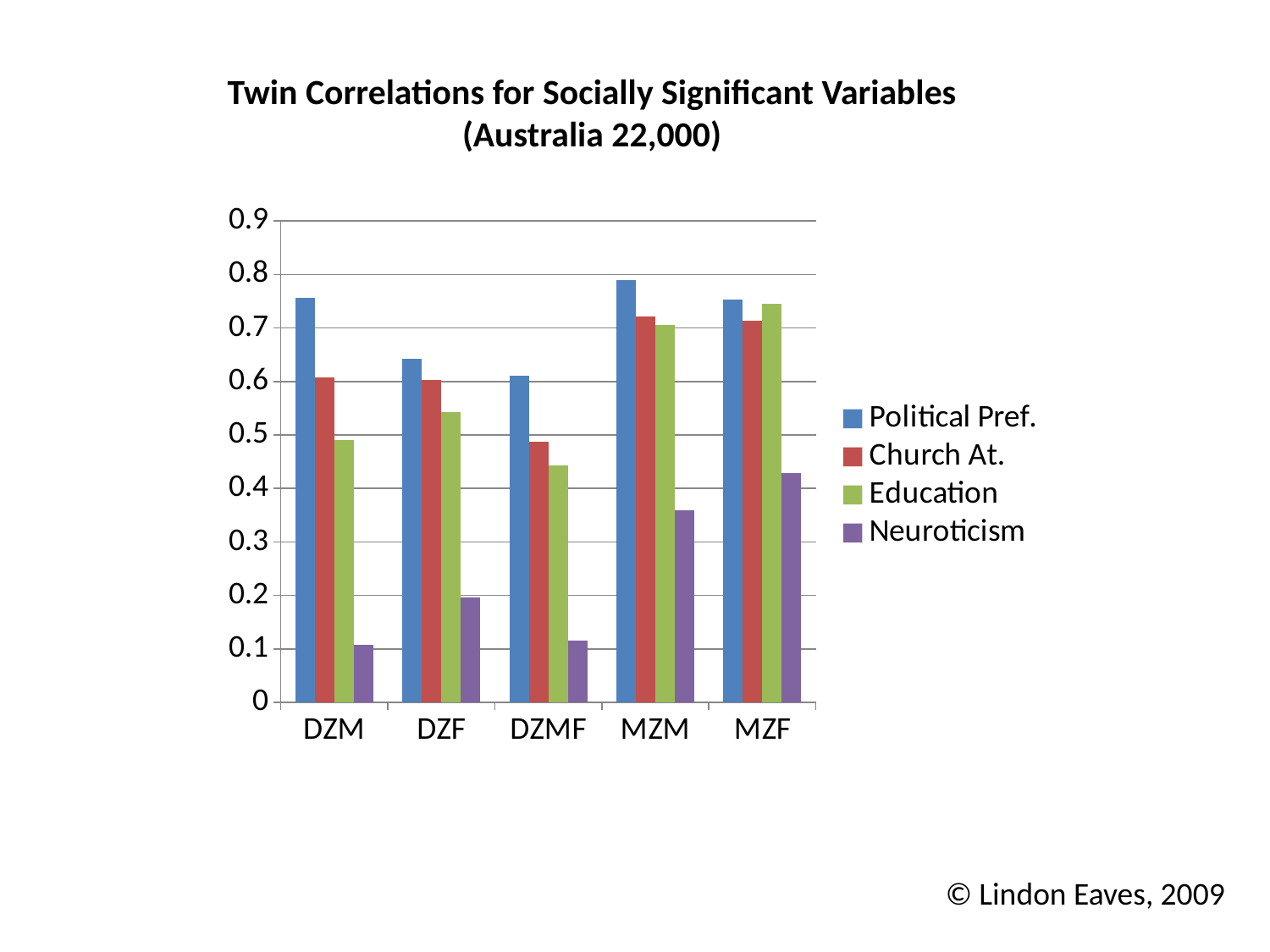
Is the Neuroticism value for DZM greater or less than 0.2? less What is the title of the chart? Twin Correlations for Socially Significant Variables (Australia 22,000) Which group has the larger Political Pref. value, DZM or DZF? DZM How many twin groups (categories) are shown on the x axis? 5 Is the Neuroticism value for MZM greater or less than 0.4? less For which twin group is the Neuroticism correlation highest? MZF For DZM, which is larger: Political Pref. or Neuroticism? Political Pref. How many series does the legend list? 4 For which twin group is the Education correlation lowest? DZMF What kind of chart is shown on the slide? bar chart Is the Political Pref. value for MZM greater or less than 0.7? greater For which twin group is the Political Pref. correlation highest? MZM